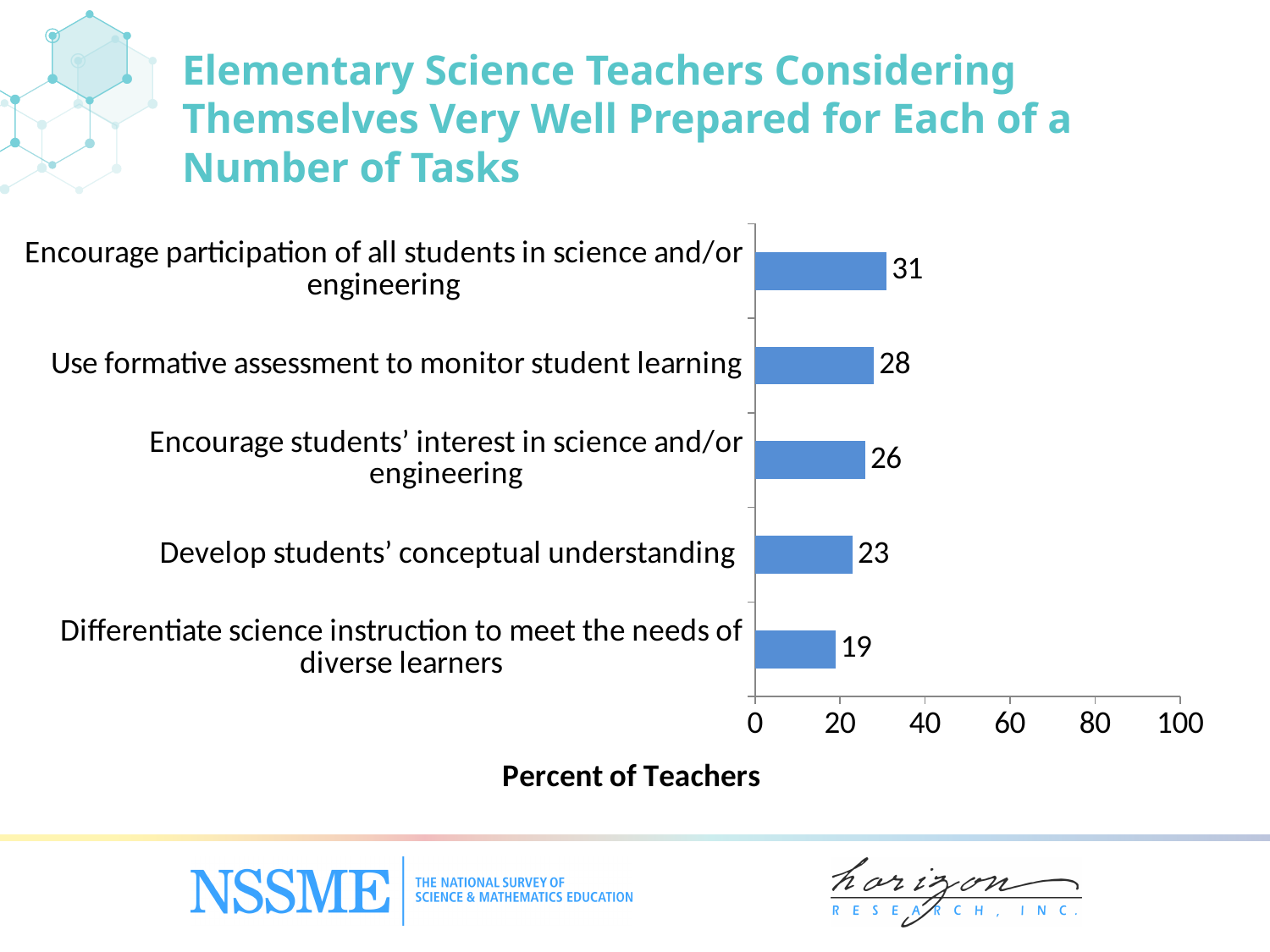
What kind of chart is shown on the slide? bar chart What is the label of the horizontal axis? Percent of Teachers What is the difference between the values for 'Encourage participation of all students in science and/or engineering' and 'Differentiate science instruction to meet the needs of diverse learners'? 12 How many tasks are shown in the chart? 5 What is the value for 'Differentiate science instruction to meet the needs of diverse learners'? 19 Which task has the lowest percent of teachers? Differentiate science instruction to meet the needs of diverse learners Which task has the highest percent of teachers? Encourage participation of all students in science and/or engineering Which is larger: the value for 'Encourage students' interest in science and/or engineering' or 'Develop students' conceptual understanding'? Encourage students' interest in science and/or engineering What is the value for 'Use formative assessment to monitor student learning'? 28 Is the value for 'Develop students' conceptual understanding' greater or less than 40? less What is the difference between the values for 'Use formative assessment to monitor student learning' and 'Develop students' conceptual understanding'? 5 What percent of teachers consider themselves very well prepared to encourage participation of all students in science and/or engineering? 31